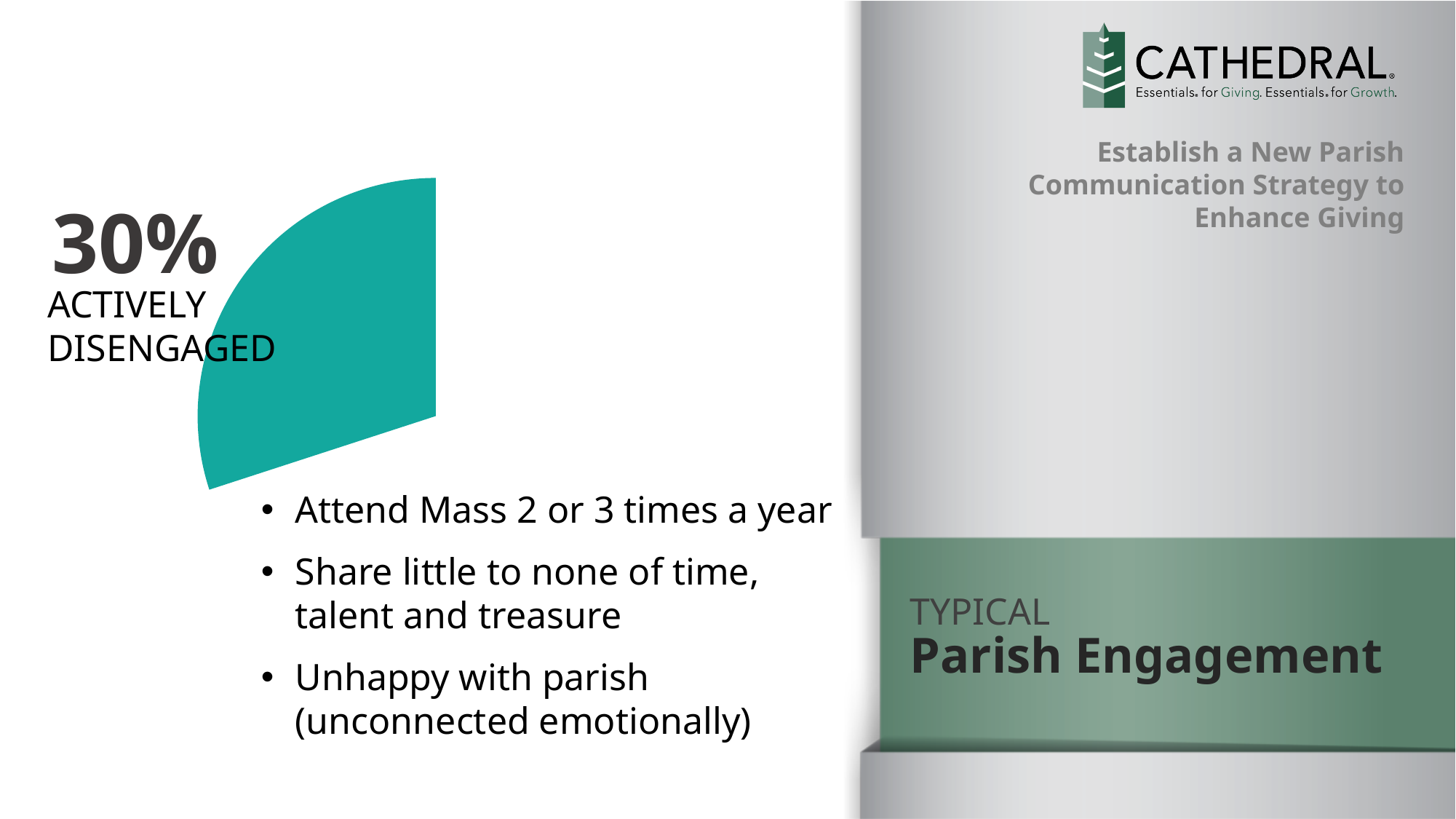
What label is attached to the 30% slice? Actively Disengaged Is the Actively Disengaged share greater or less than 50%? less How many slices are labelled on the chart? 1 What percentage is shown for the Actively Disengaged slice? 30% What share of the whole does the Actively Disengaged slice represent? 30% What kind of chart is the teal shape on the slide? pie chart What colour is the Actively Disengaged slice? teal